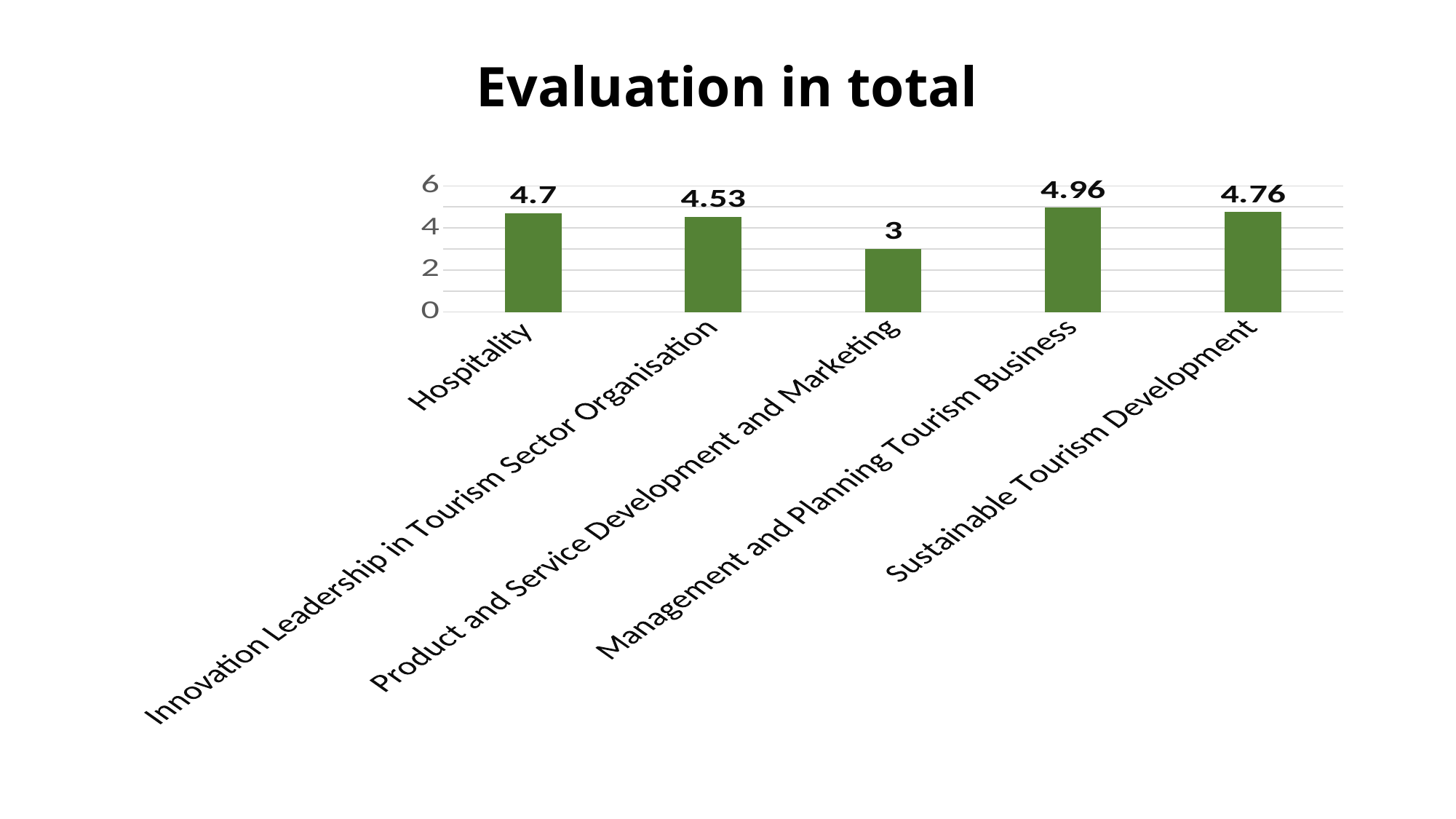
What is the value for Innovation Leadership in Tourism Sector Organisation? 4.53 What kind of chart is shown on the slide? Bar chart Which is larger, the value for Hospitality or the value for Sustainable Tourism Development? Sustainable Tourism Development What is the value for Management and Planning Tourism Business? 4.96 What is the difference between the values for Management and Planning Tourism Business and Product and Service Development and Marketing? 1.96 How many categories are shown in the chart? 5 Which category has the lowest value? Product and Service Development and Marketing What is the value for Product and Service Development and Marketing? 3 What is the value for Hospitality? 4.7 What is the title of the chart? Evaluation in total What is the value for Sustainable Tourism Development? 4.76 Which category has the highest value? Management and Planning Tourism Business